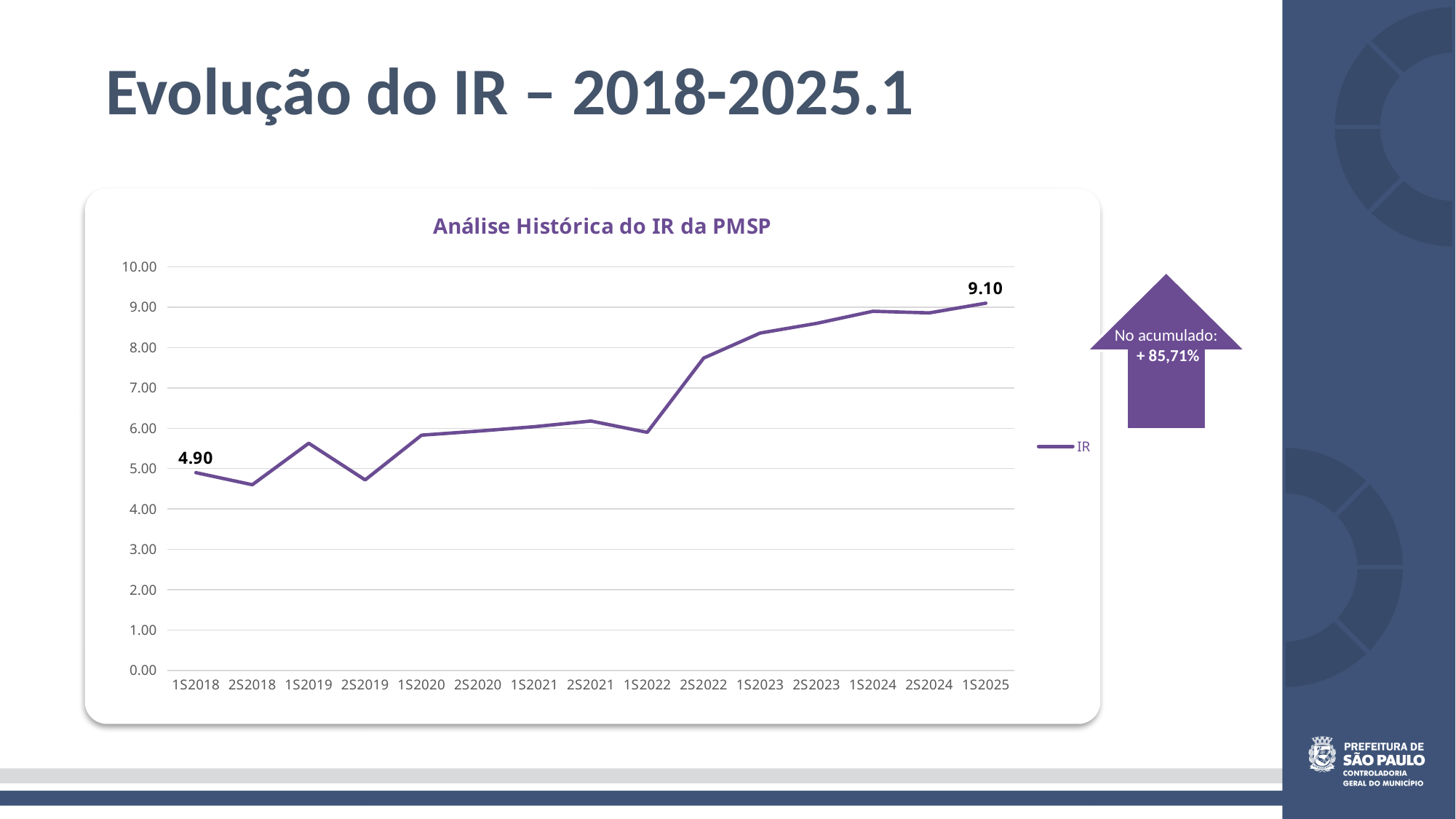
How many series does the legend list? 1 Overall, do the IR values rise or fall from 1S2018 to 1S2025? Rise Which period has the highest IR value? 1S2025 What is the value of IR for 1S2018? 4.90 What is the title of the chart? Análise Histórica do IR da PMSP What is the value of IR for 1S2025? 9.10 What is the difference between the IR value for 1S2025 and the IR value for 1S2018? 4.20 What kind of chart is shown on the slide? Line chart How many periods are plotted along the x axis? 15 Is the value for 2S2019 greater or less than 5.00? less Which is larger, the IR value for 1S2019 or for 2S2019? 1S2019 Is the value for 2S2022 greater or less than 7.00? greater